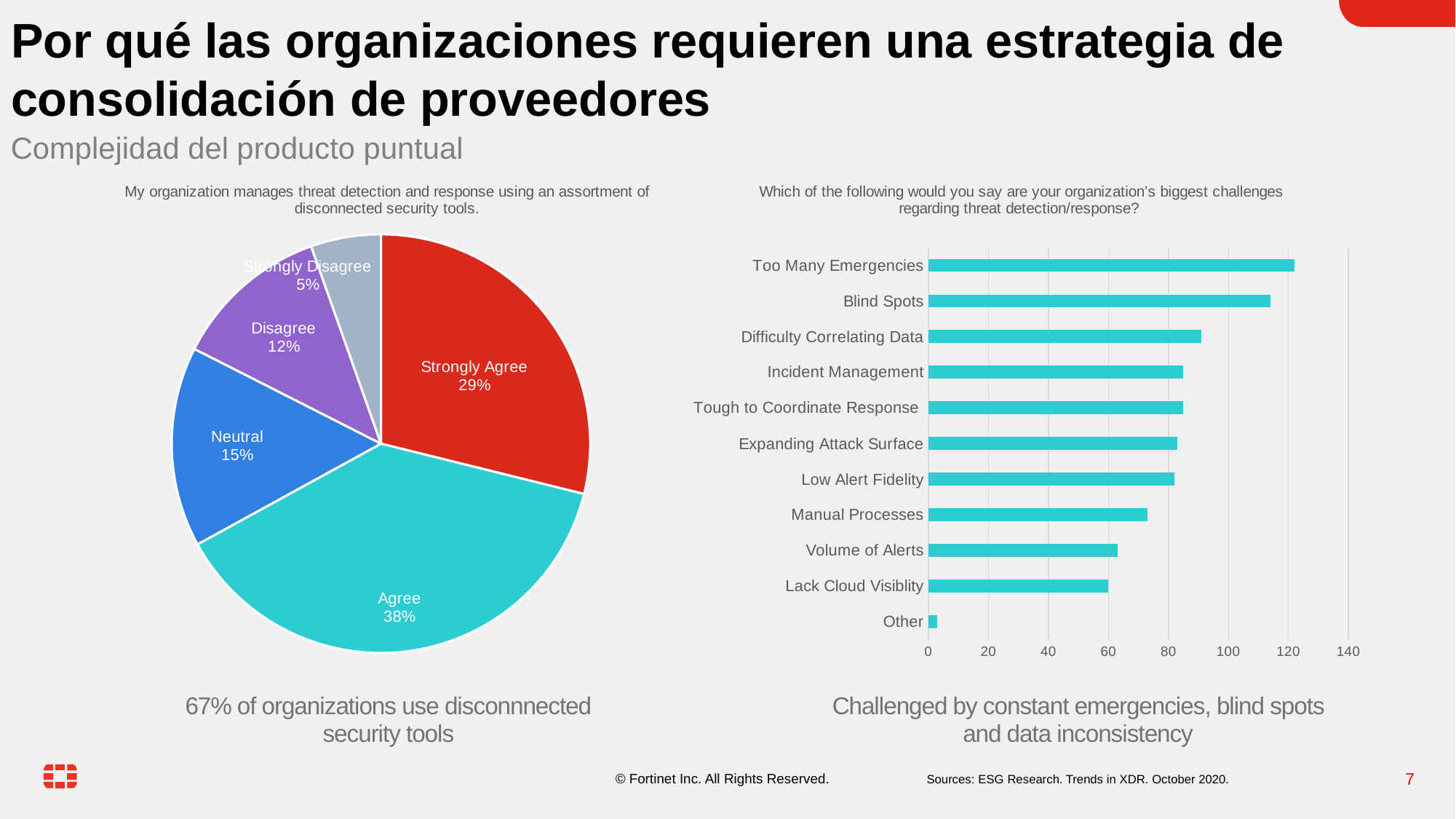
In the bar chart on the right, which challenge has the lowest value? Other In the pie chart on the left, what percentage of respondents chose Agree? 38% In the pie chart on the left, how many slices are there? 5 In the pie chart on the left, what percentage of respondents chose Strongly Disagree? 5% In the bar chart on the right, which challenge has the highest value? Too Many Emergencies In the pie chart on the left, which response has the smallest share? Strongly Disagree In the bar chart on the right, which is larger: Blind Spots or Difficulty Correlating Data? Blind Spots In the pie chart on the left, which response has the largest share? Agree In the bar chart on the right, is the value for Lack Cloud Visiblity greater or less than 80? less In the pie chart on the left, what is the difference in percentage points between Strongly Agree and Neutral? 14 In the bar chart on the right, how many challenges are listed? 11